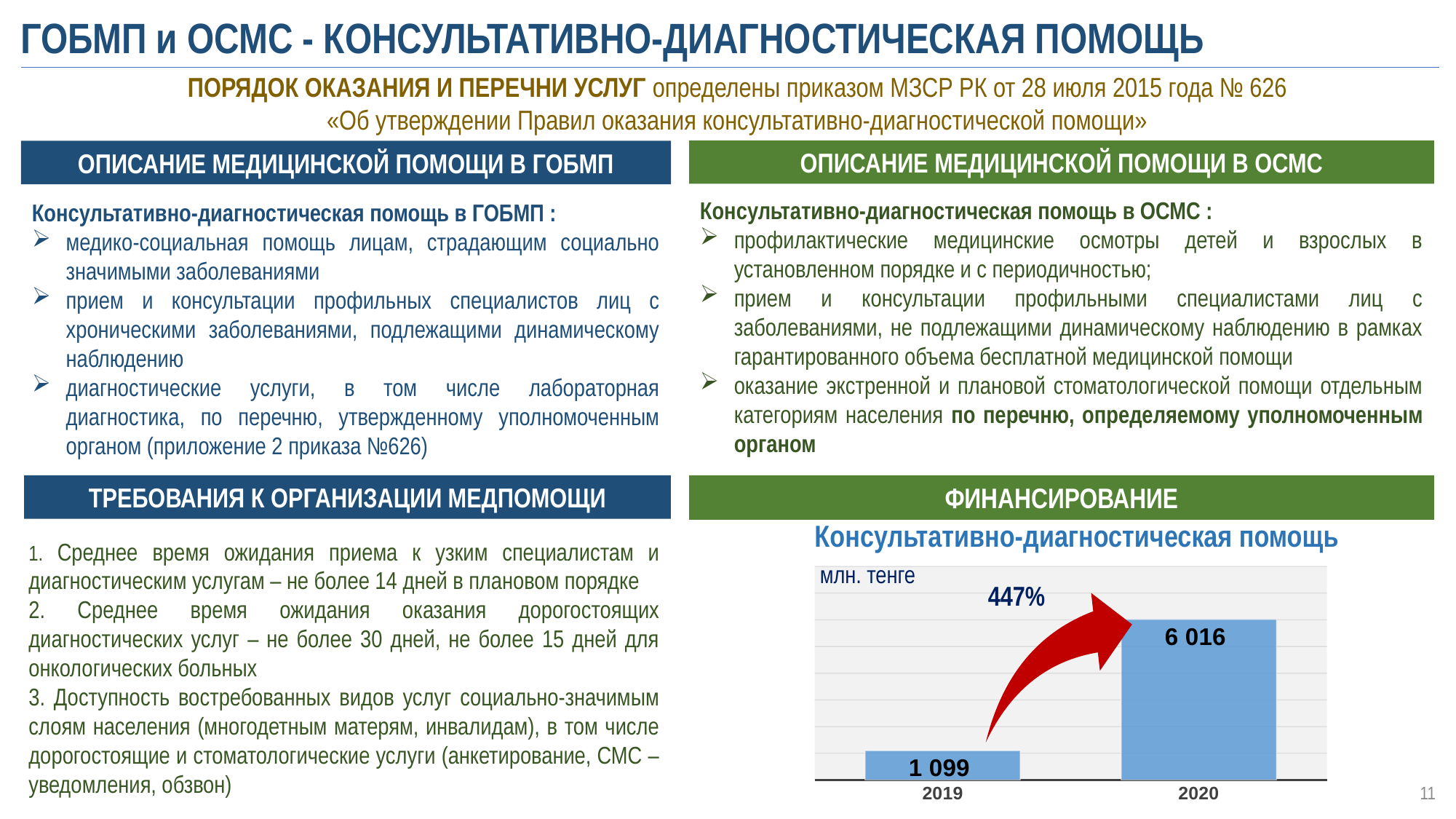
How many bars are shown in the chart? 2 Which year has the lowest value in the chart? 2019 Do the values in the chart rise or fall from 2019 to 2020? rise What is the value for 2020 in the chart? 6 016 What unit is shown in the chart? млн. тенге What percentage is printed next to the arrow in the chart? 447% Which year has the highest value in the chart? 2020 What is the difference between the 2020 and 2019 values in the chart? 4 917 Which is larger in the chart, the value for 2019 or the value for 2020? 2020 What is the value for 2019 in the chart? 1 099 What kind of chart is shown on the slide? bar chart What is the title of the chart? Консультативно-диагностическая помощь